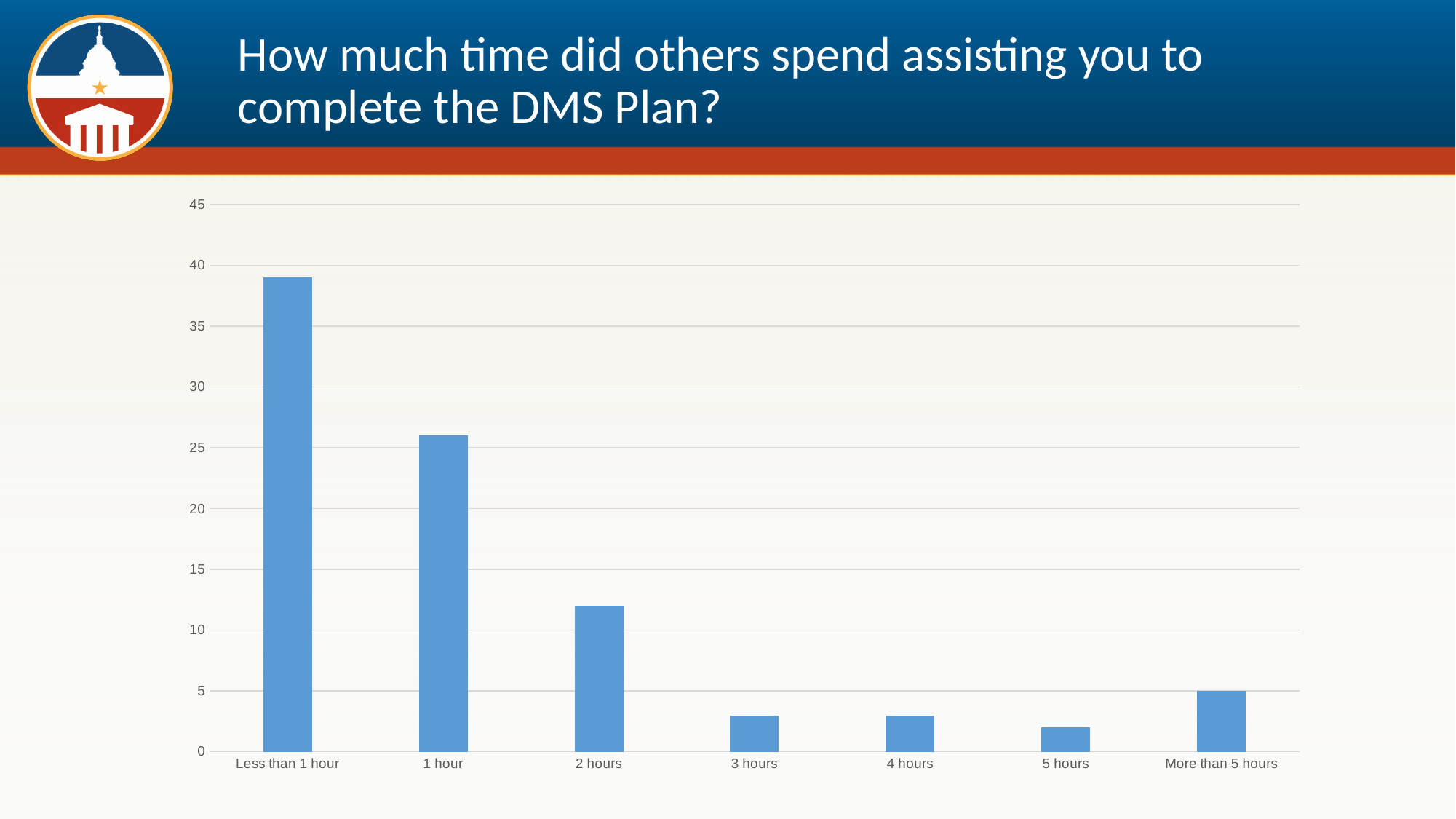
What kind of chart is shown on the slide? bar chart Is the value for 1 hour greater or less than 20? greater Which category has the lowest value in the chart? 5 hours Is the value for 3 hours greater or less than 5? less Do the values rise or fall from Less than 1 hour to 5 hours along the x axis? fall Which category has the highest value in the chart? Less than 1 hour Which is larger, the value for Less than 1 hour or the value for 1 hour? Less than 1 hour How many categories are shown on the x axis of the chart? 7 Which is larger, the value for 2 hours or the value for More than 5 hours? 2 hours Is the value for Less than 1 hour greater or less than 35? greater What is the value for More than 5 hours? 5